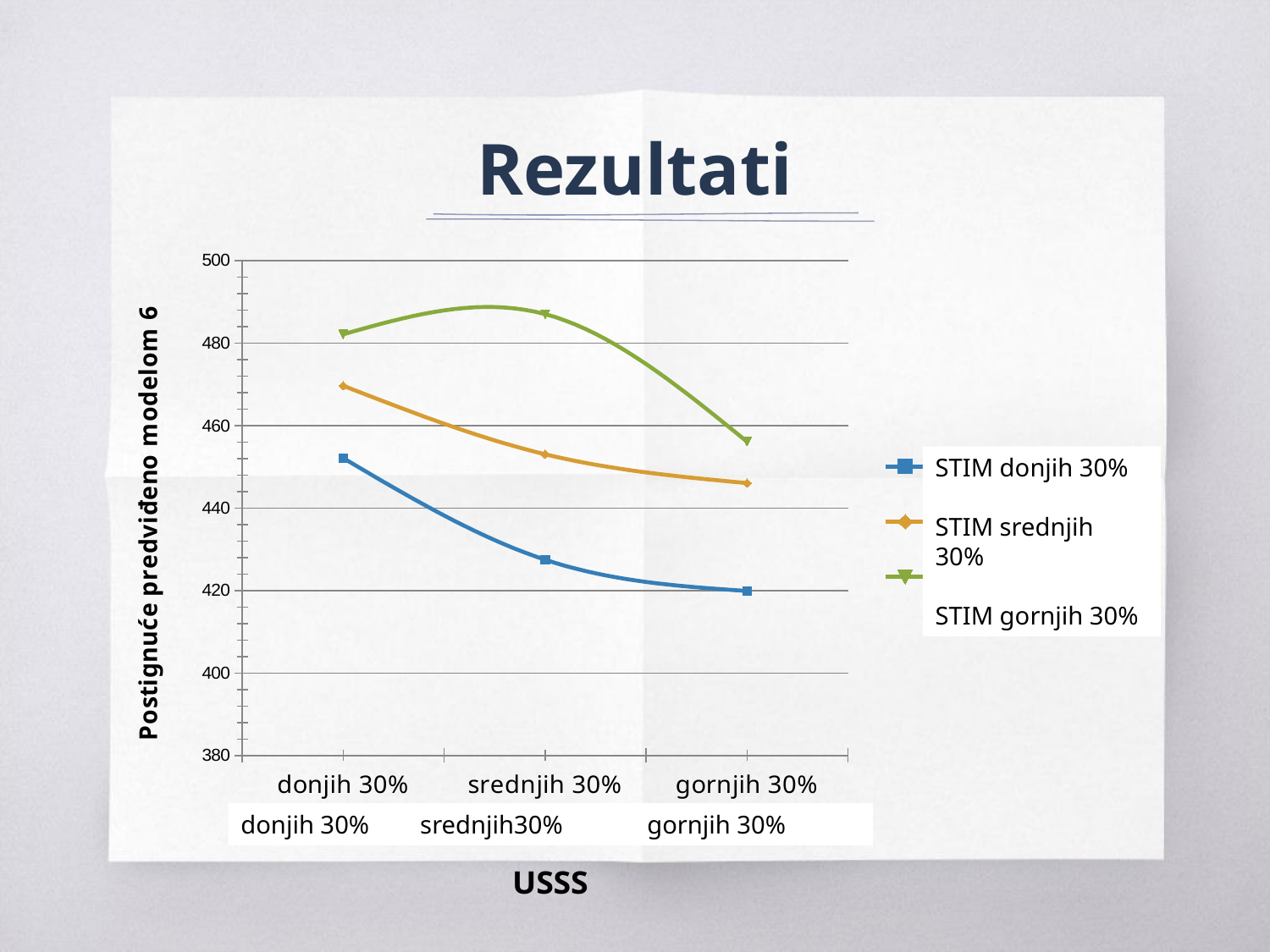
Which series has the lowest value at gornjih 30%? STIM donjih 30% Is the value for STIM donjih 30% at gornjih 30% greater or less than 440? less Is the value for STIM srednjih 30% at gornjih 30% greater or less than 460? less Is the value for STIM srednjih 30% at donjih 30% greater or less than 460? greater What kind of chart is shown on the slide? line chart How many categories are shown on the x axis? 3 What is the title of the x axis? USSS How many series does the legend list? 3 Do the values for STIM donjih 30% rise or fall from donjih 30% to gornjih 30%? fall At donjih 30%, which series has the higher value, STIM gornjih 30% or STIM donjih 30%? STIM gornjih 30%